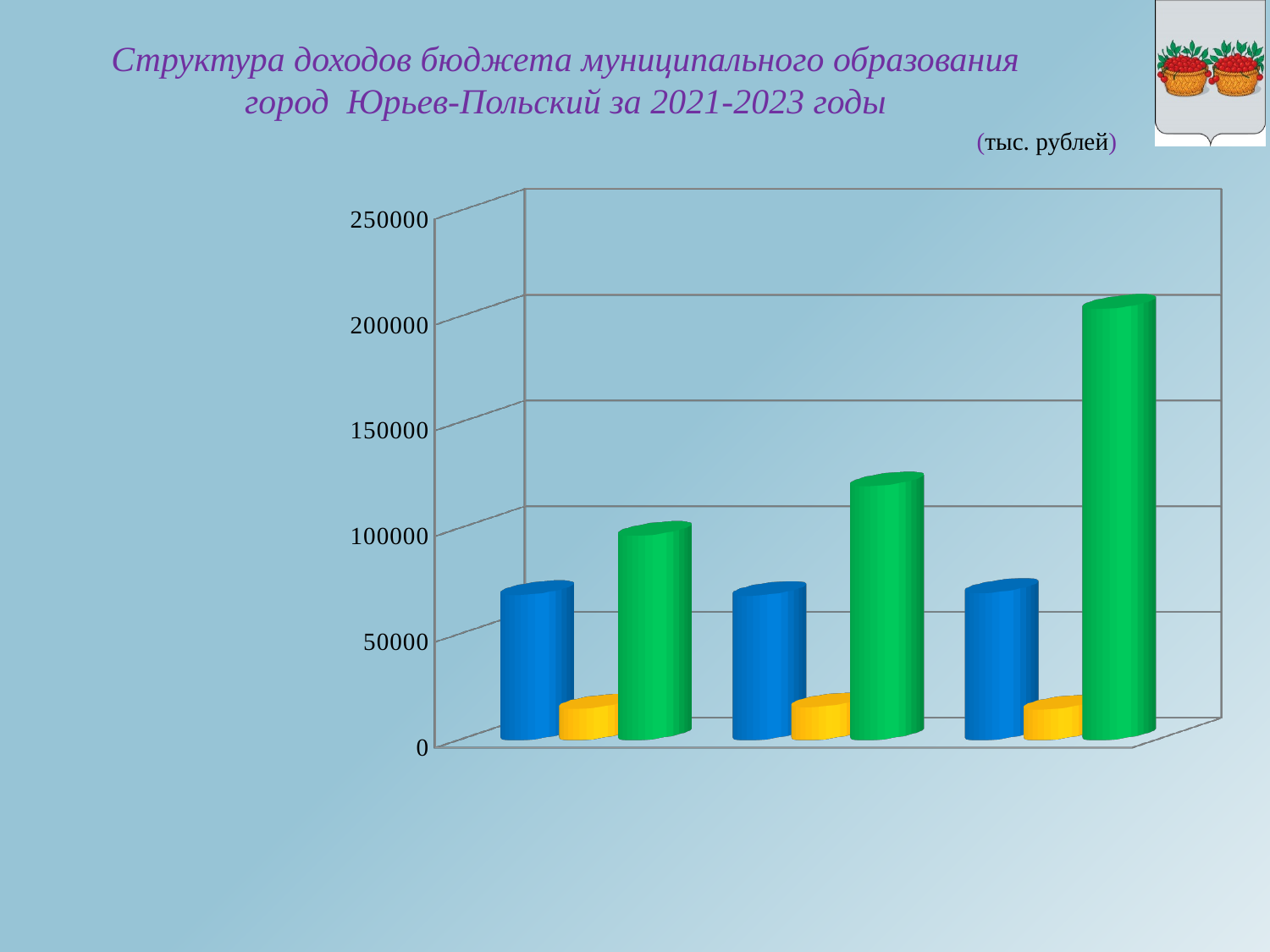
Is the blue bar in the leftmost group greater or less than 100000? less Which years does the chart title say the data covers? 2021-2023 Which bar is the tallest on the chart? the green bar in the rightmost group Is the yellow bar in the middle group greater or less than 50000? less Do the green bars rise or fall from left to right across the groups? rise How many groups of bars are plotted along the x axis? 3 Is the green bar in the leftmost group greater or less than 50000? greater What kind of chart is shown on the slide? bar chart How many bars are there in each group? 3 In the middle group, which is larger, the blue bar or the green bar? the green bar What unit of measurement is stated for the chart values? тыс. рублей